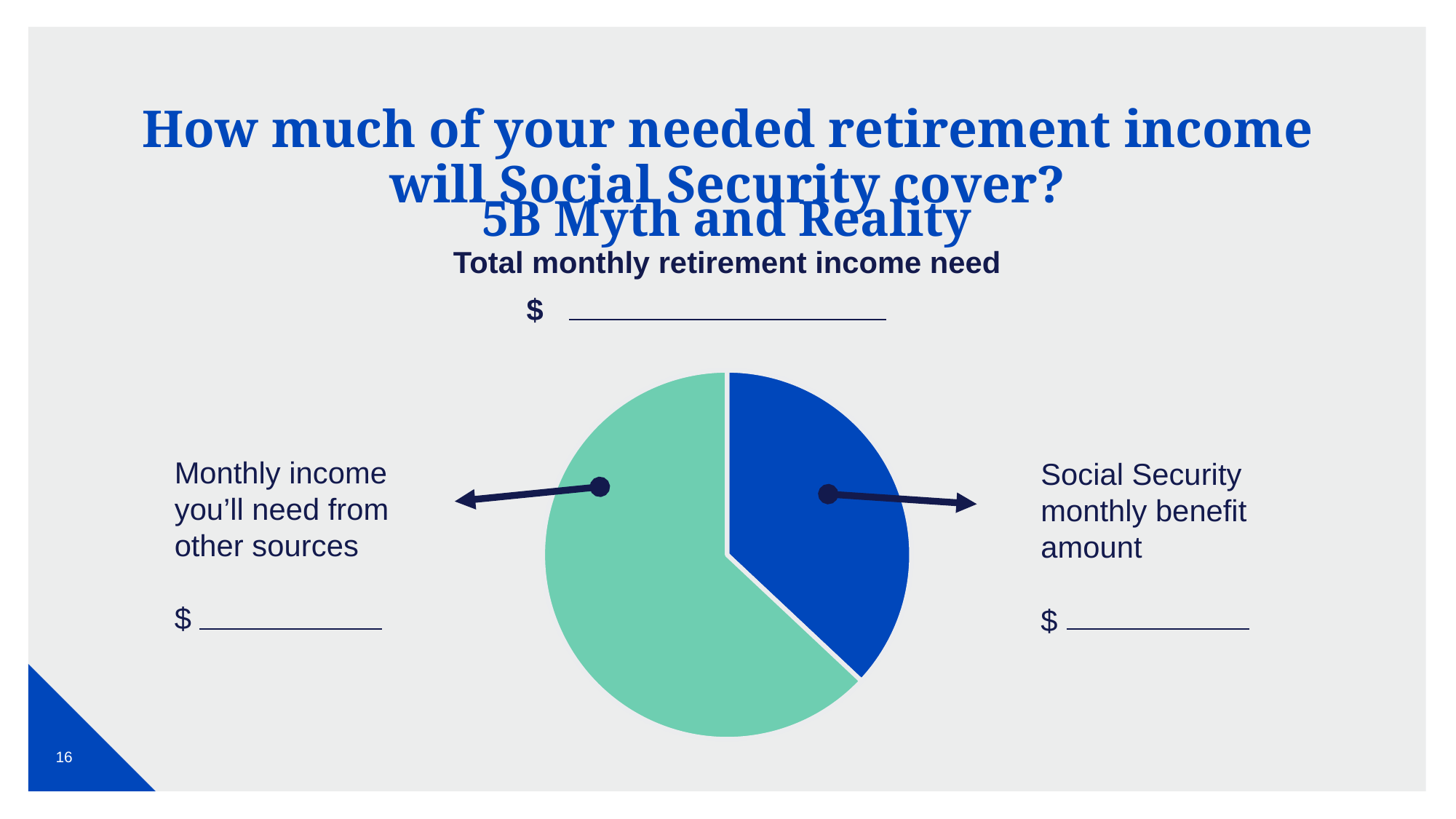
Which is larger in the pie chart: the slice for Social Security monthly benefit amount or the slice for monthly income you'll need from other sources? Monthly income you'll need from other sources How many slices does the pie chart have? 2 What heading appears directly above the pie chart? Total monthly retirement income need Is the slice for monthly income you'll need from other sources more or less than half of the pie? more Which slice of the pie chart is the smallest? Social Security monthly benefit amount Which slice of the pie chart is the largest? Monthly income you'll need from other sources What colour is the slice for Social Security monthly benefit amount? blue What kind of chart is shown on the slide? pie chart Is the slice for Social Security monthly benefit amount more or less than half of the pie? less